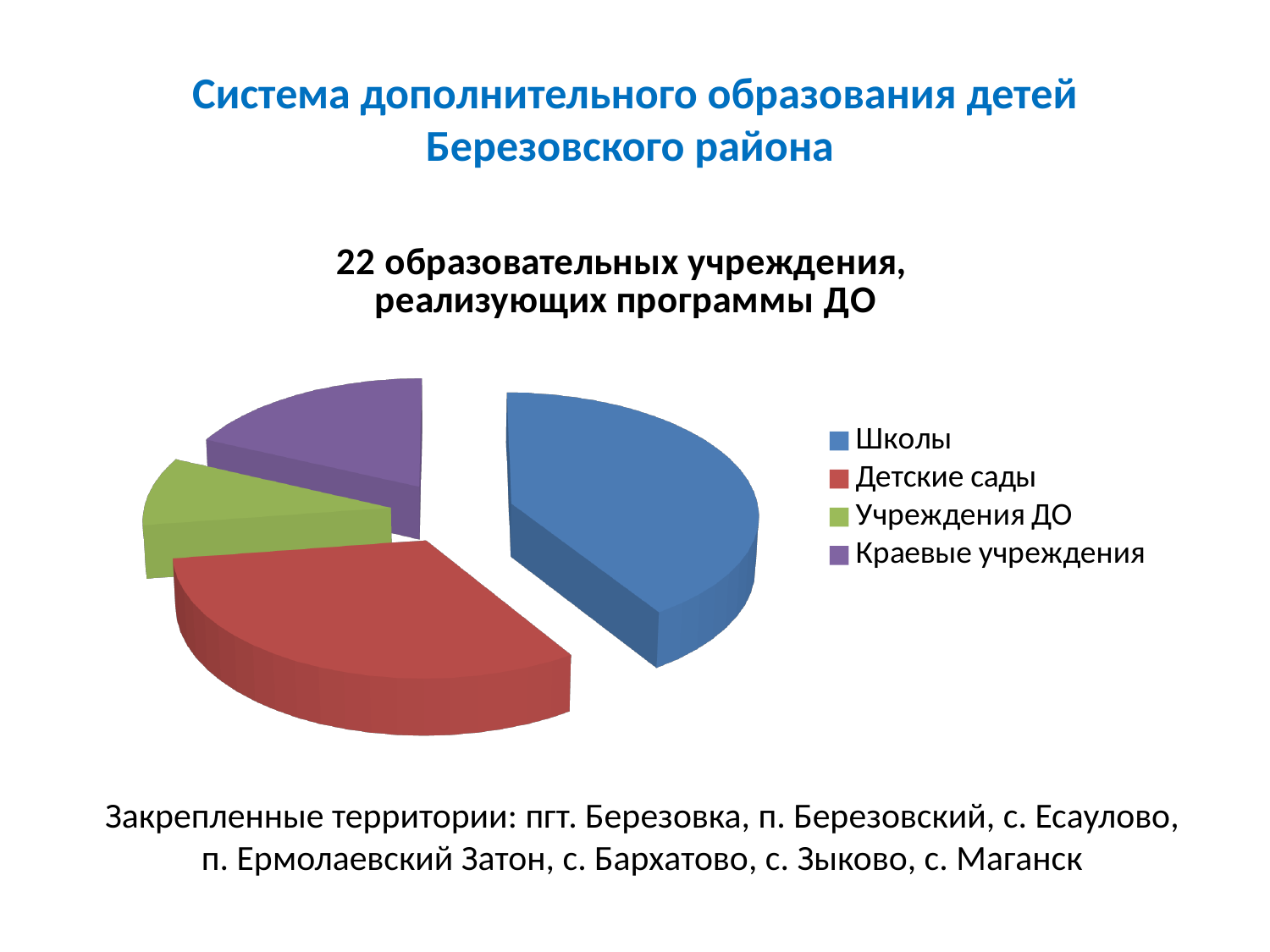
How many slices does the pie chart have? 4 Which category is shown in green in the pie chart? Учреждения ДО What kind of chart is shown on the slide? Pie chart Which slice is larger in the pie chart: Школы or Учреждения ДО? Школы How many entries does the legend of the pie chart list? 4 Which slice is larger in the pie chart: Детские сады or Краевые учреждения? Детские сады What is the title of the pie chart? 22 образовательных учреждения, реализующих программы ДО Which category has the smallest slice in the pie chart? Учреждения ДО Which slice is larger in the pie chart: Учреждения ДО or Краевые учреждения? Краевые учреждения